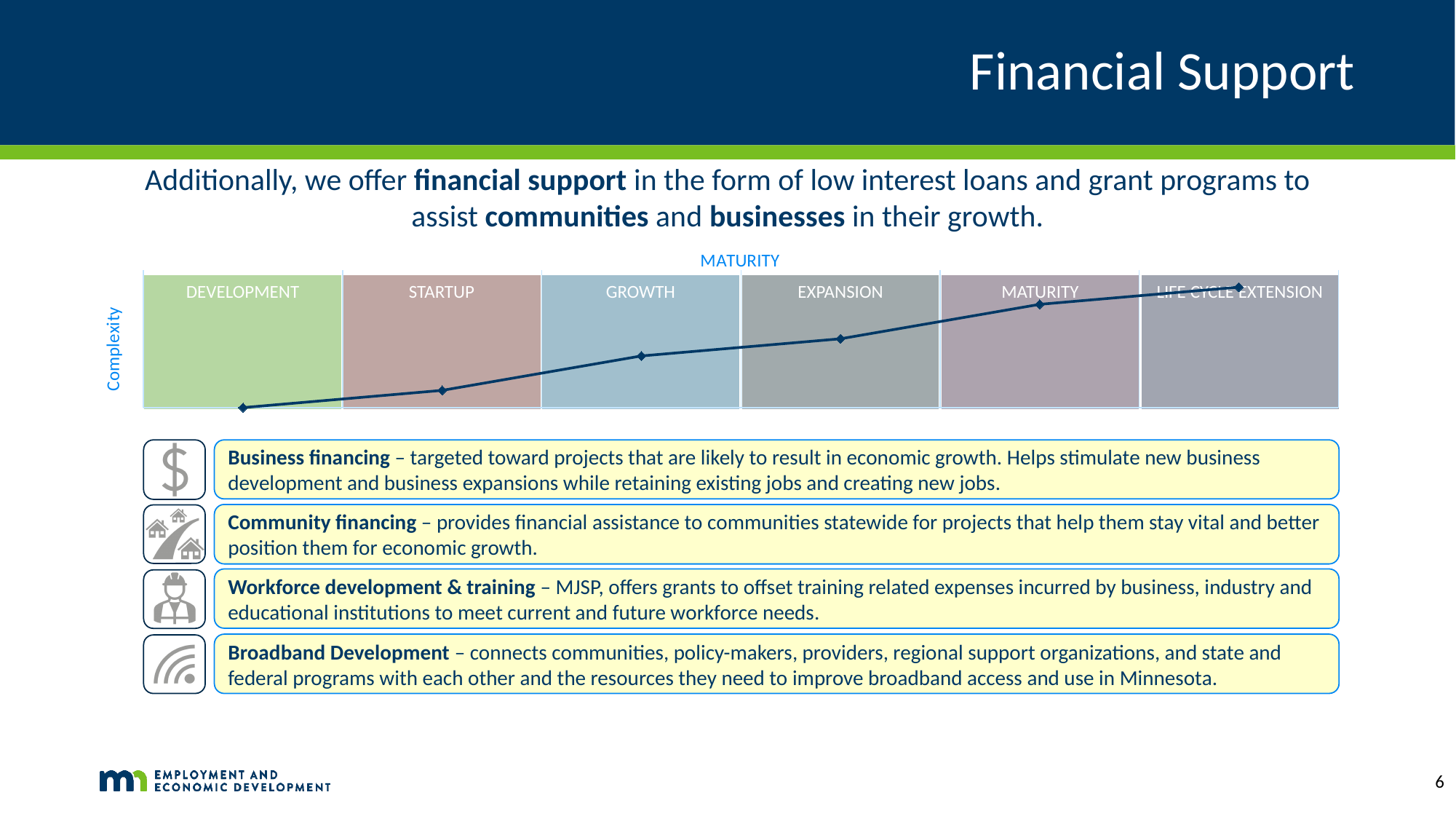
Which stage has the highest point on the line? Life Cycle Extension What kind of chart is shown on the slide? line chart Which stage has the lowest point on the line? Development What is the label of the fourth stage on the x axis of the chart? Expansion Which stage has the higher point on the line, Startup or Expansion? Expansion Which stage has the higher point on the line, Growth or Maturity? Maturity What is the label of the vertical axis of the chart? Complexity How many stages are plotted along the x axis of the chart? 6 What is the label of the horizontal axis of the chart? Maturity Does the plotted line rise or fall as it moves from Development to Life Cycle Extension? rise Which stage has the lower point on the line, Development or Growth? Development What is the label of the first stage on the x axis of the chart? Development